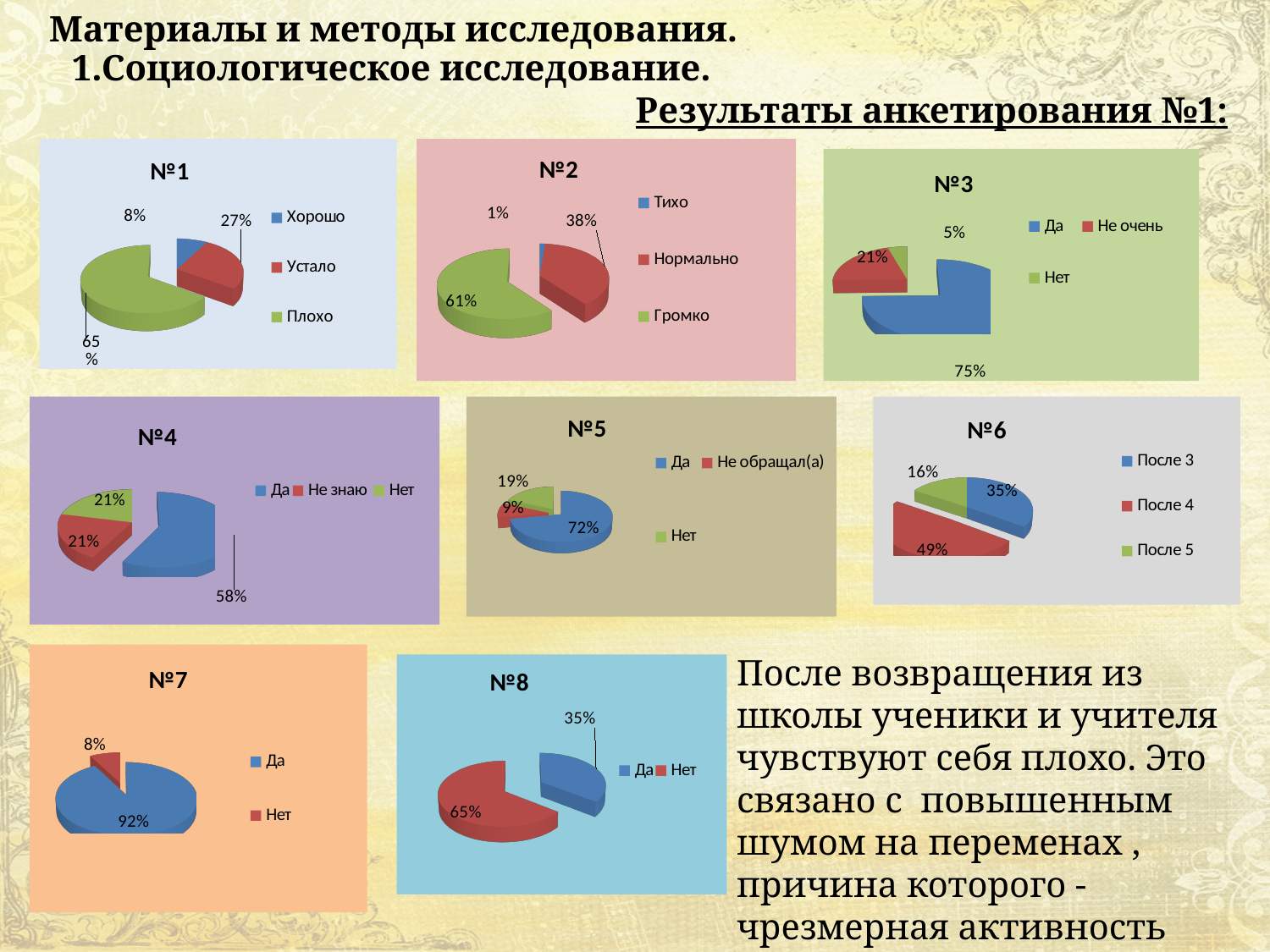
How many slices does chart №4 have? 3 How many pie charts are shown on the slide? 8 In chart №2, which category has the smallest share? Тихо In chart №5, which category has the largest share? Да In chart №8, what is the difference between the "Нет" and "Да" shares? 30% In chart №7, what percentage is shown for "Нет"? 8% In chart №6, what percentage is shown for "После 4"? 49% In chart №3, what percentage is shown for "Да"? 75% How many entries does the legend of chart №7 list? 2 In chart №2, what percentage is shown for "Громко"? 61% What type of chart is chart №1? Pie chart In chart №6, which is larger: "После 3" or "После 5"? После 3